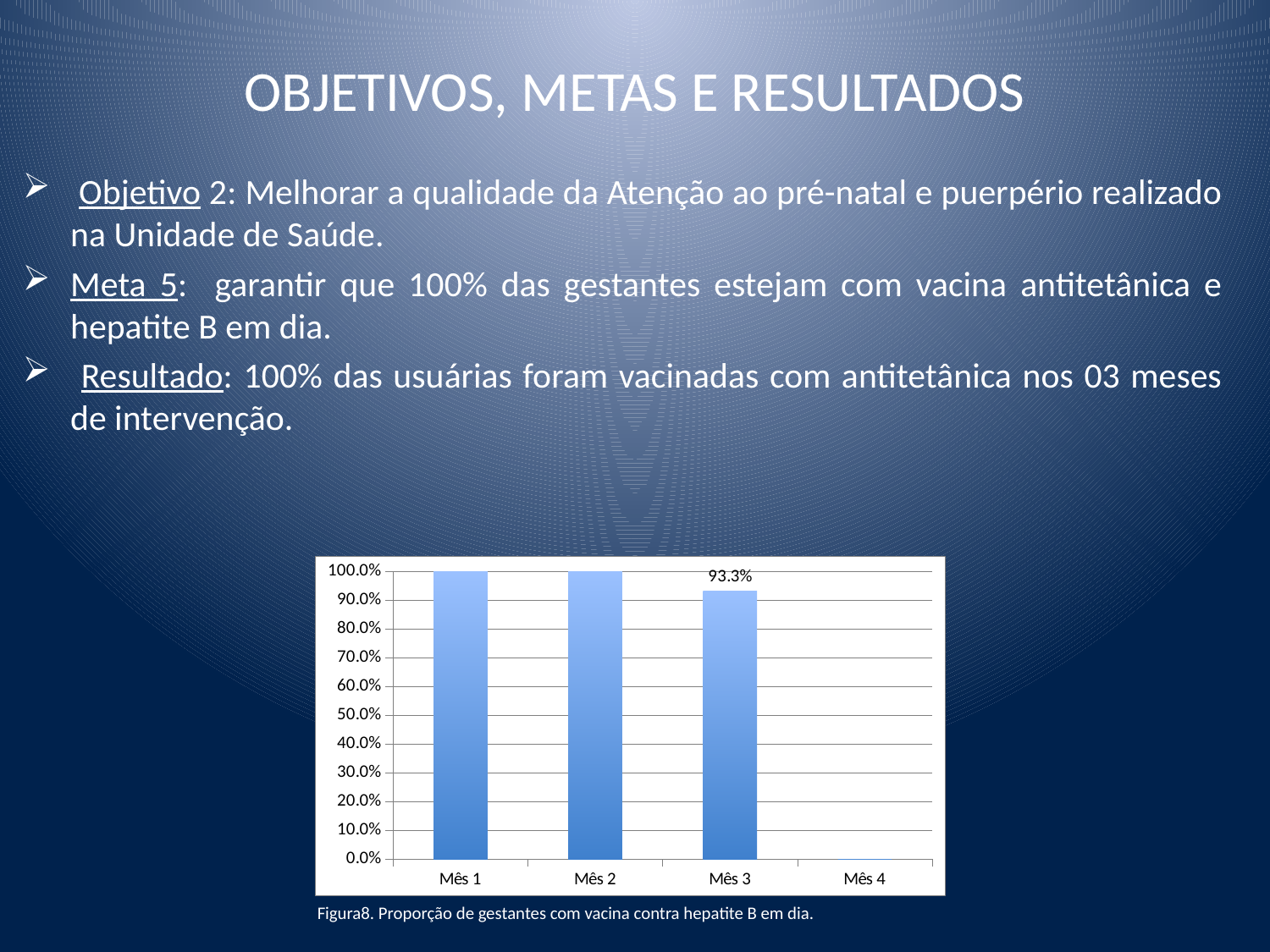
Is the value for Mês 3 greater or less than 90.0%? greater What is the value for Mês 2? 100.0% What is the caption of the figure below the chart? Figura8. Proporção de gestantes com vacina contra hepatite B em dia. Is the value for Mês 3 greater or less than 100.0%? less Which is larger, the value for Mês 2 or the value for Mês 3? Mês 2 What is the value for Mês 3? 93.3% Which category on the x axis has no bar plotted? Mês 4 What type of chart is shown on the slide? bar chart What is the value for Mês 1? 100.0% What is the difference between the value for Mês 1 and the value for Mês 3? 6.7% Which month has the lowest value among the months with a bar? Mês 3 How many categories are shown on the x axis? 4